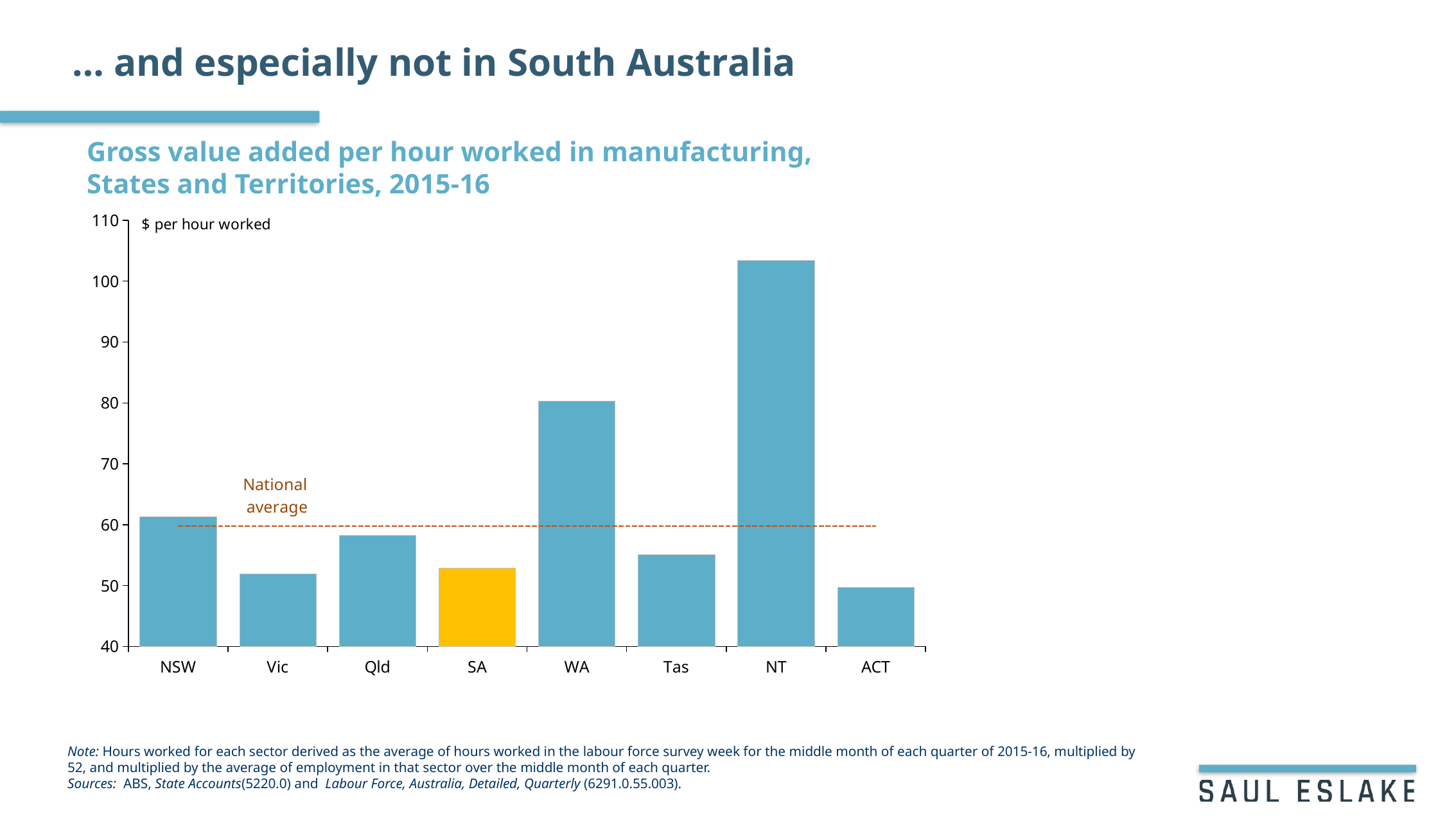
Which state's bar is highlighted in a different colour (yellow) from the others? SA What kind of chart is shown on the slide? Bar chart Is the value for NT greater or less than 100? greater Which has a higher gross value added per hour worked, SA or Qld? Qld Is the value for SA greater or less than 60? less Is the value for WA greater or less than 70? greater What does the dashed horizontal line on the chart represent? National average How many states and territories are plotted on the chart? 8 Which state or territory has the lowest gross value added per hour worked in manufacturing? ACT Which has a higher gross value added per hour worked, WA or Tas? WA Which state or territory has the highest gross value added per hour worked in manufacturing? NT